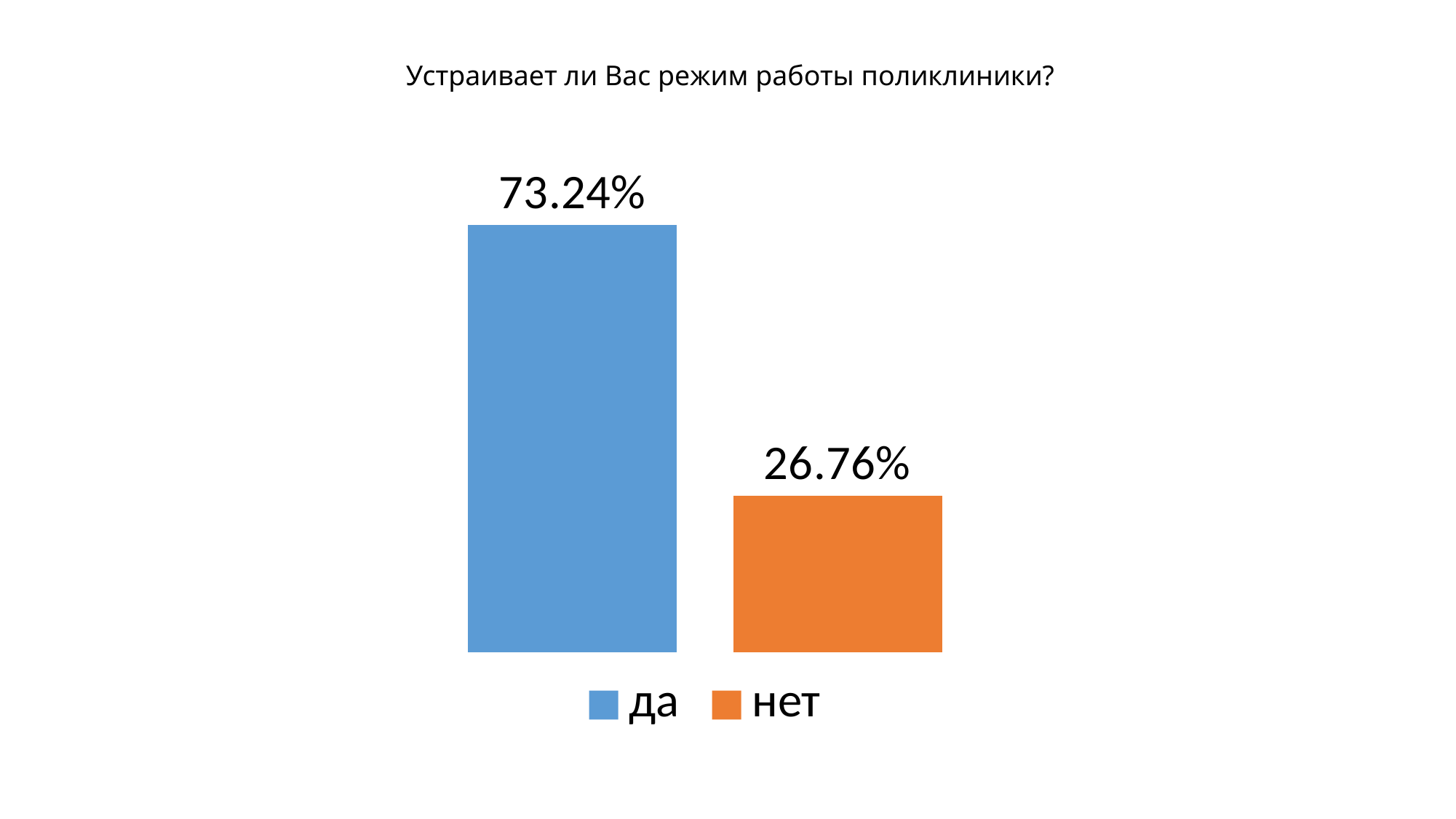
What colour is the bar for "нет"? orange What is the title of the chart? Устраивает ли Вас режим работы поликлиники? How many categories are shown in the chart? 2 What is the value for "да"? 73.24% How many entries does the legend list? 2 Which is larger, the value for "да" or the value for "нет"? да Which category has the highest value? да What is the value for "нет"? 26.76% Which category has the lowest value? нет What is the difference between the values for "да" and "нет"? 46.48% What kind of chart is shown on the slide? bar chart What is the total of the two values shown? 100%